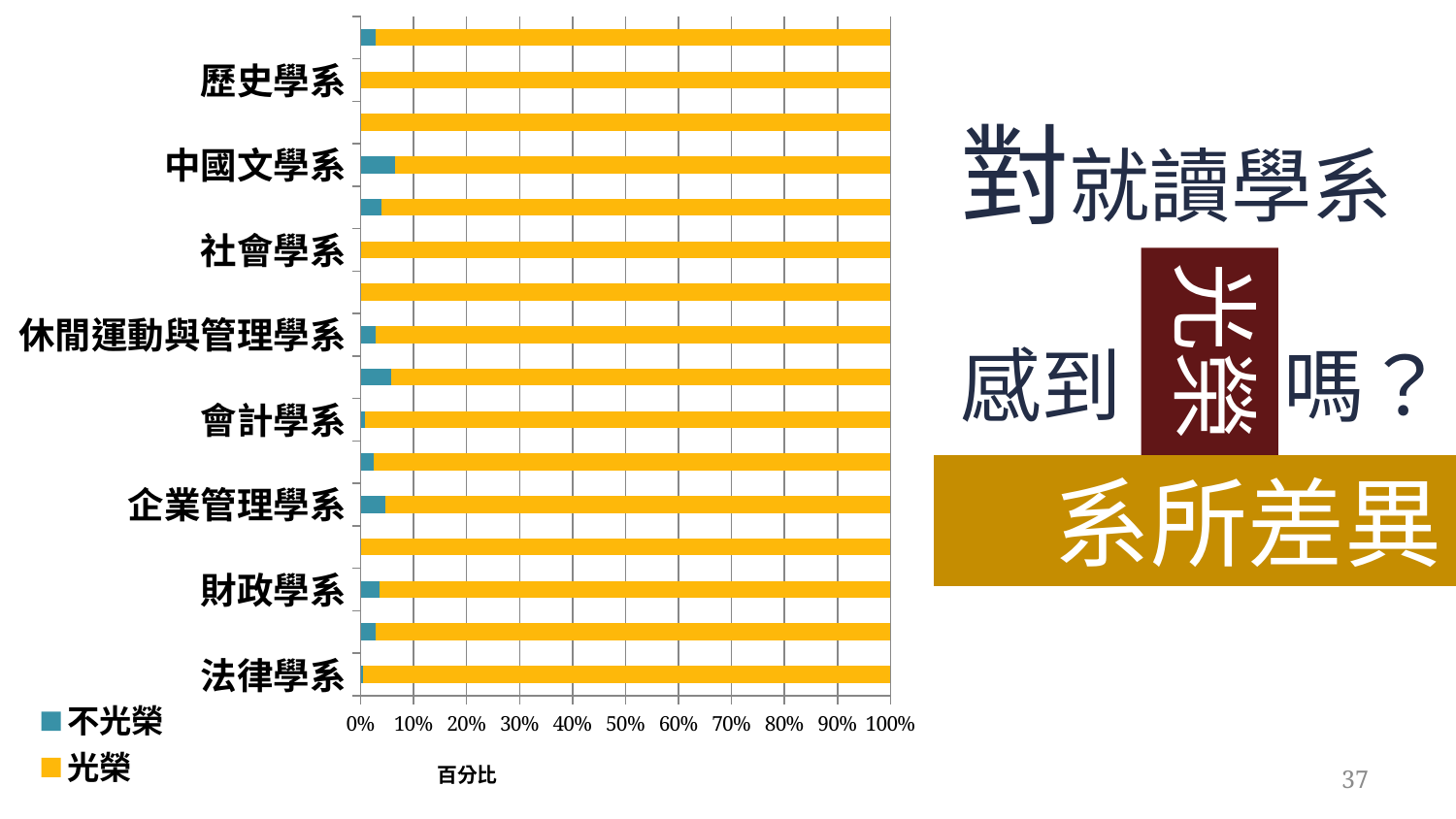
Which colour represents the 光榮 series in the chart? Yellow/orange Which has the larger 不光榮 share, 中國文學系 or 會計學系? 中國文學系 What are the two series named in the chart legend? 不光榮 and 光榮 Is the 光榮 value for 中國文學系 greater or less than 90%? greater What kind of chart is shown on the slide? Stacked bar chart Is the 光榮 value for 法律學系 greater or less than 90%? greater What is the title of the horizontal axis of the chart? 百分比 Among the labeled departments, which has the largest 不光榮 share? 中國文學系 Is the 不光榮 value for 企業管理學系 greater or less than 10%? less Which has the larger 光榮 share, 歷史學系 or 中國文學系? 歷史學系 How many series does the chart legend list? 2